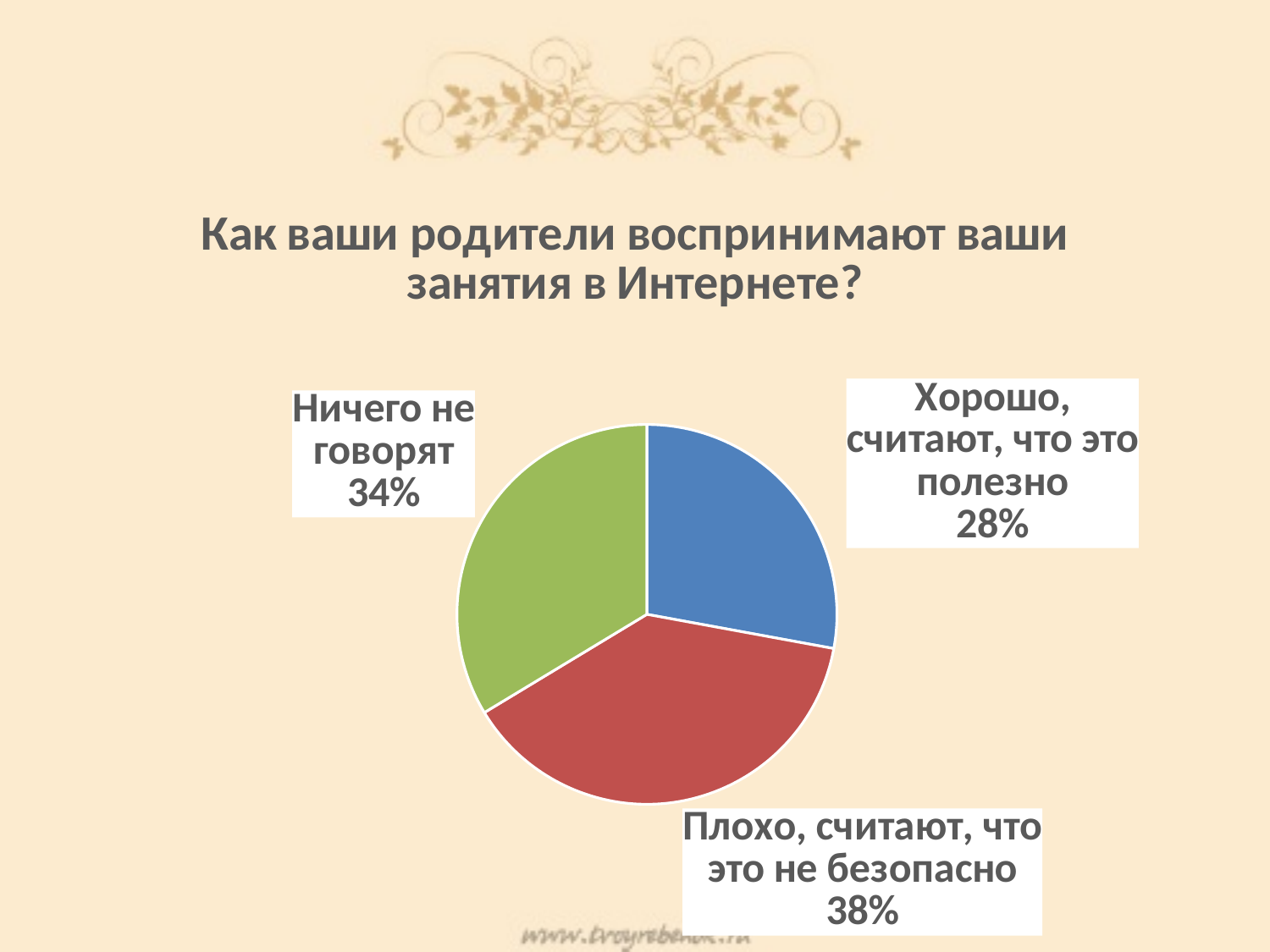
What is the difference in percentage points between "Плохо, считают, что это не безопасно" and "Хорошо, считают, что это полезно"? 10 What is the title of the chart? Как ваши родители воспринимают ваши занятия в Интернете? What share of respondents answered "Ничего не говорят"? 34% Which answer has the largest share of the pie? Плохо, считают, что это не безопасно Which is larger: the share for "Ничего не говорят" or the share for "Хорошо, считают, что это полезно"? Ничего не говорят What is the difference in percentage points between "Плохо, считают, что это не безопасно" and "Ничего не говорят"? 4 What share of respondents answered "Хорошо, считают, что это полезно"? 28% What kind of chart is shown on the slide? pie chart Which answer has the smallest share of the pie? Хорошо, считают, что это полезно What share of respondents answered "Плохо, считают, что это не безопасно"? 38% How many slices does the pie chart have? 3 What colour is the slice for "Ничего не говорят"? green